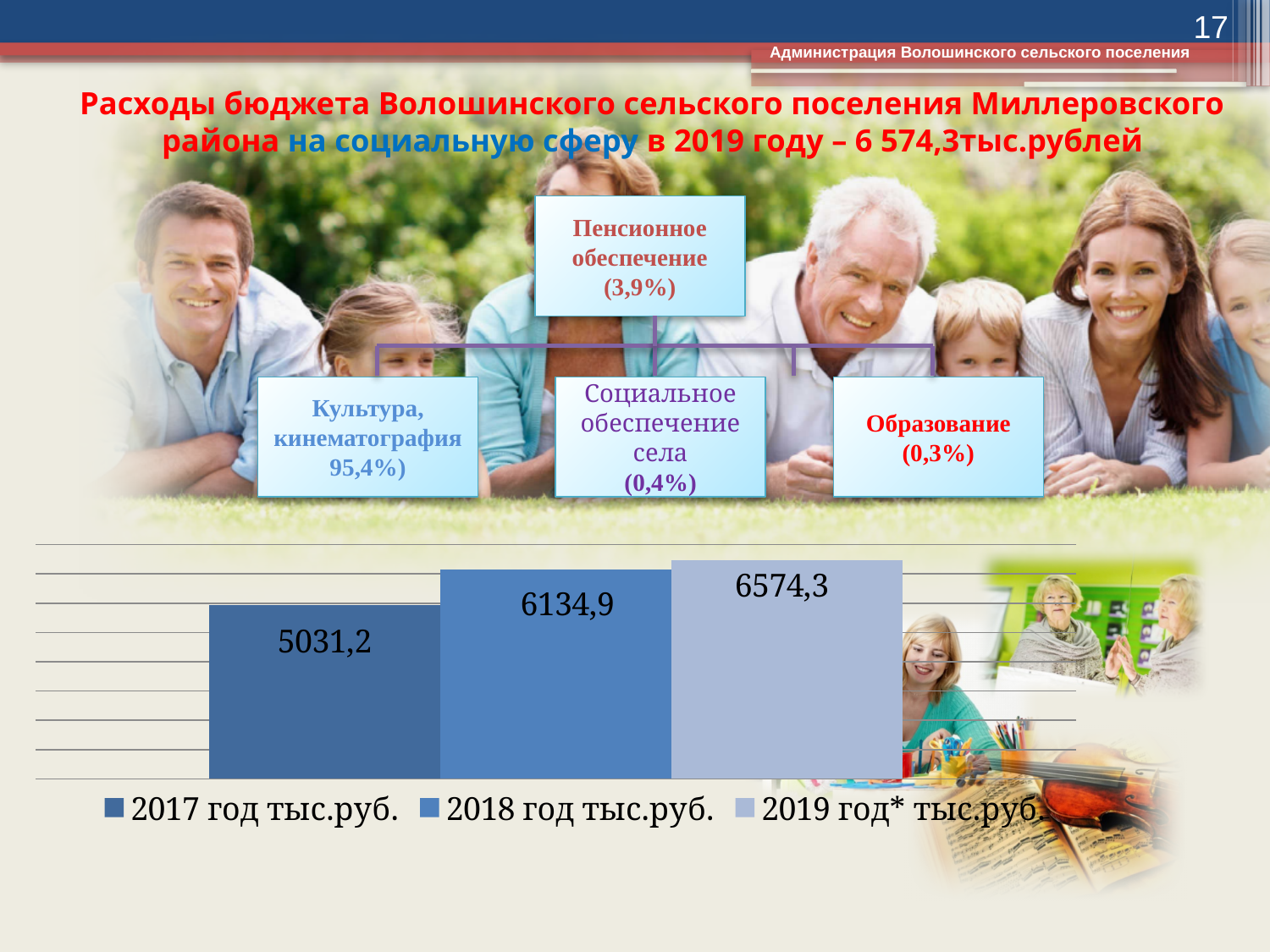
How many series does the legend of the bar chart list? 3 What is the value shown for 2017 год тыс.руб. in the bar chart? 5031,2 Which is larger in the bar chart, the value for 2017 год or the value for 2018 год? 2018 год What is the difference between the 2019 год* and 2018 год values in the bar chart? 439,4 Which year has the lowest value in the bar chart? 2017 год тыс.руб. Do the values in the bar chart rise or fall from 2017 to 2019? Rise What kind of chart is shown at the bottom of the slide? Bar chart What is the difference between the 2019 год* and 2017 год values in the bar chart? 1543,1 What is the value shown for 2019 год* тыс.руб. in the bar chart? 6574,3 What is the value shown for 2018 год тыс.руб. in the bar chart? 6134,9 Which year has the highest value in the bar chart? 2019 год* тыс.руб. What is the difference between the 2018 год and 2017 год values in the bar chart? 1103,7